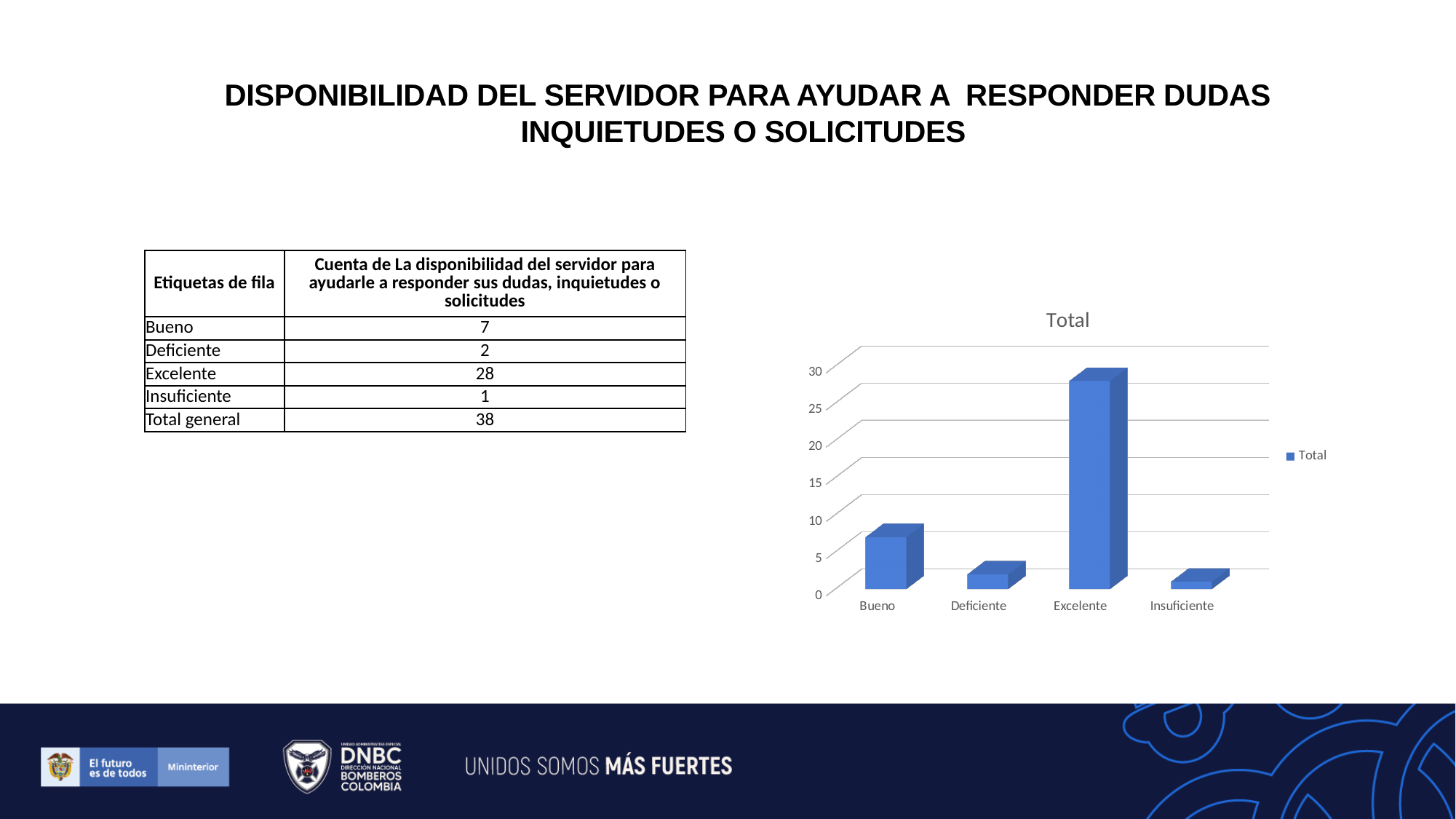
How many categories are shown on the x axis of the chart? 4 Is the value for Bueno greater or less than 10? less Which category has the highest value in the chart? Excelente What type of chart is shown on the slide? bar chart Which category has the lowest value in the chart? Insuficiente Is the value for Excelente greater or less than 25? greater According to the table on the slide, what is the Total general? 38 According to the table on the slide, what is the difference between the values for Excelente and Bueno? 21 According to the table on the slide, what is the value for Excelente? 28 Which is larger, the value for Bueno or the value for Deficiente? Bueno What is the title of the chart? Total How many series does the chart legend list? 1